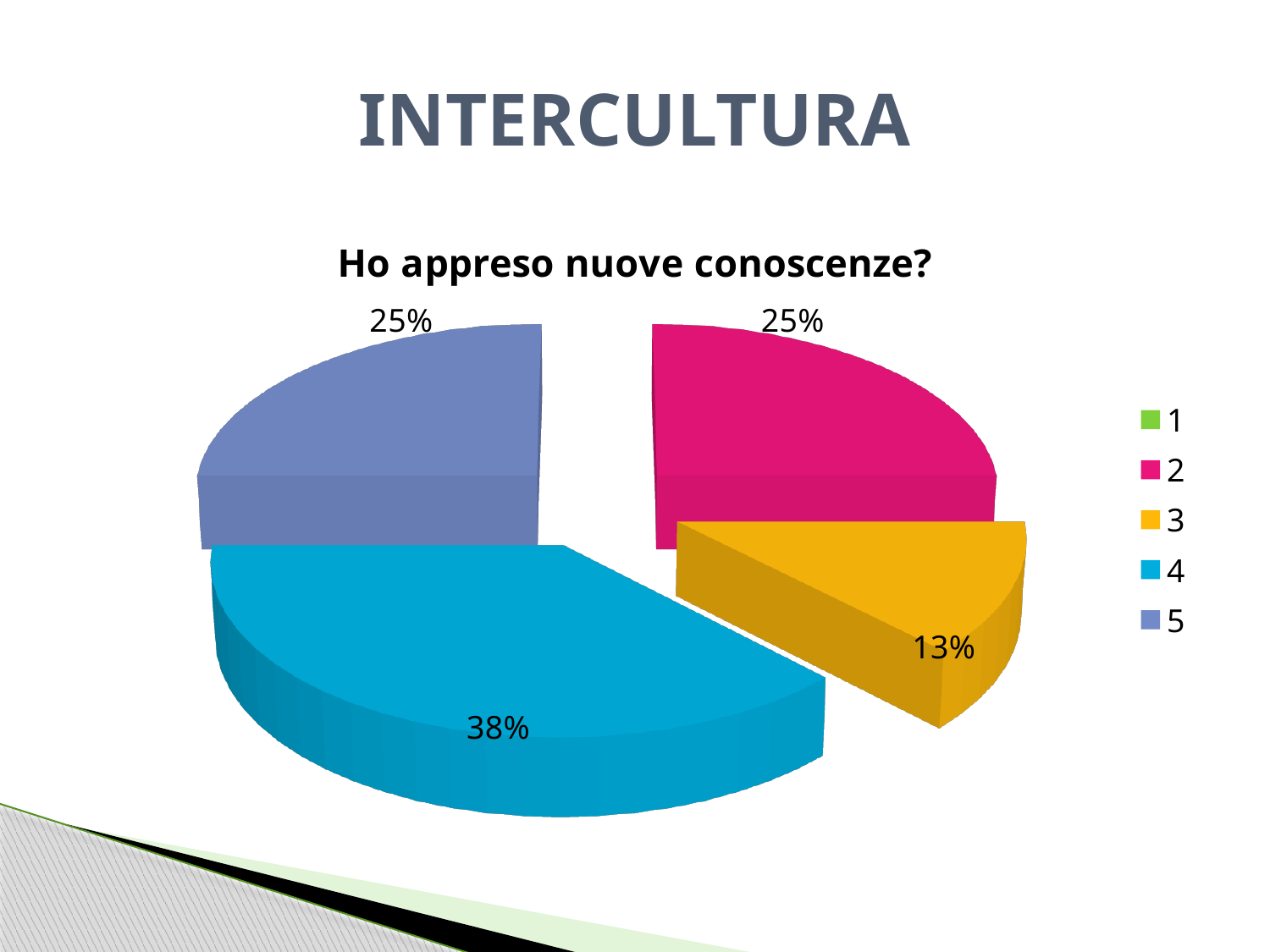
What is the difference in percentage points between the slices for category 4 and category 3? 25 Which slice is larger, category 4 or category 2? 4 How many entries does the chart legend list? 5 What share of the pie does category 2 represent? 25% What share of the pie does category 5 represent? 25% What is the title of the chart? Ho appreso nuove conoscenze? Which category has the largest slice of the pie? 4 What share of the pie does category 3 represent? 13% What kind of chart is shown on the slide? pie chart What colour is the slice for category 4? blue Which category has the smallest visible slice of the pie? 3